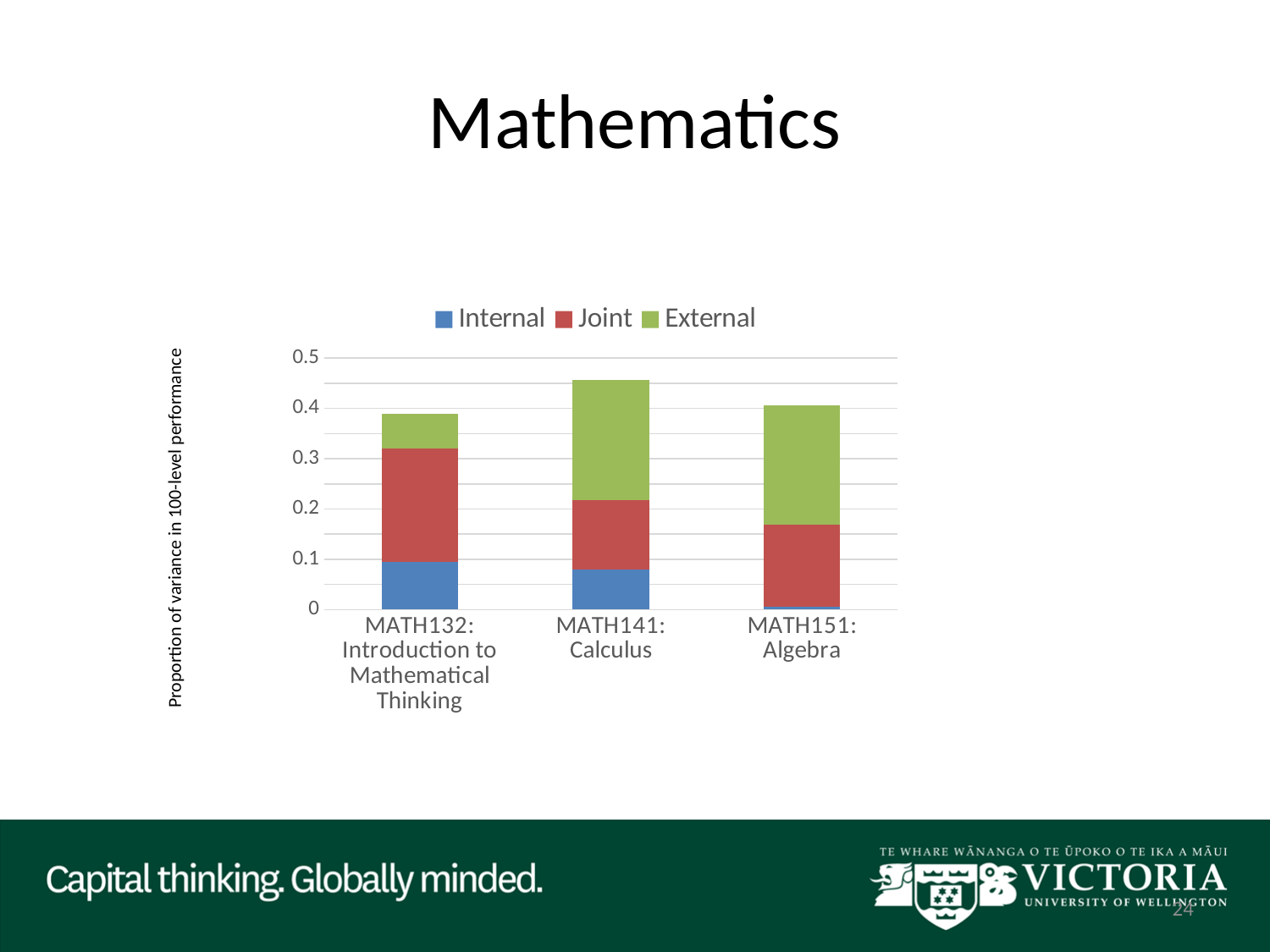
Which course has the highest total stacked bar? MATH141: Calculus What is the label of the vertical axis? Proportion of variance in 100-level performance Which course has the smallest External segment? MATH132: Introduction to Mathematical Thinking How many courses (categories) are shown on the x axis? 3 Is the total stacked value for MATH132: Introduction to Mathematical Thinking greater or less than 0.4? less What kind of chart is shown on the slide? Stacked bar chart Which colour represents the External series in the legend? Green How many series does the legend list? 3 Is the total stacked value for MATH141: Calculus greater or less than 0.4? greater Is the Internal value for MATH151: Algebra greater or less than 0.1? less Which course has the largest Joint segment? MATH132: Introduction to Mathematical Thinking Which course has the smallest Internal segment? MATH151: Algebra